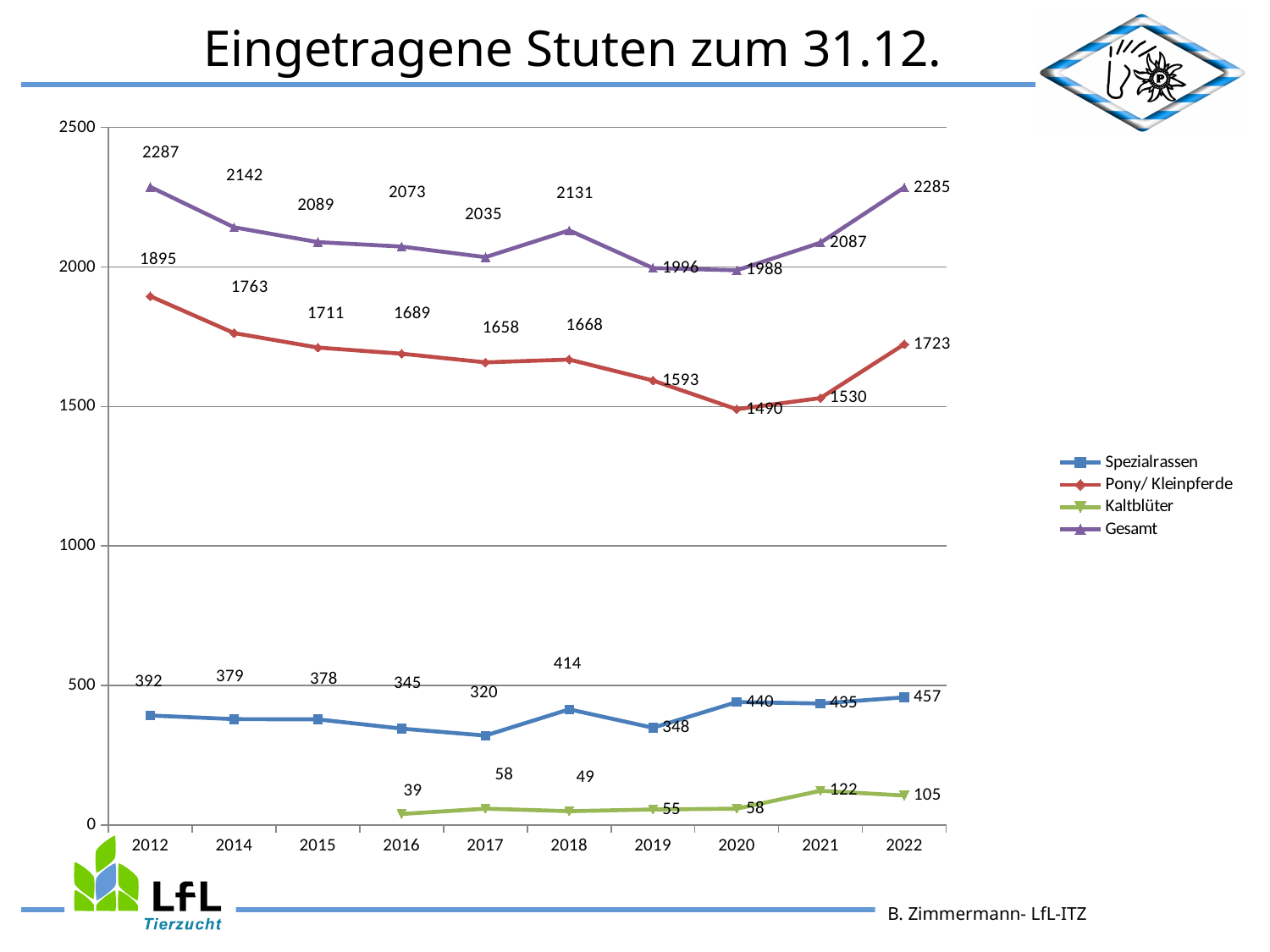
What is the value of the Gesamt series in 2012? 2287 What kind of chart is shown on the slide? line chart Does the Pony/ Kleinpferde series rise or fall from 2012 to 2020? fall What is the difference between the Gesamt value in 2012 and the Gesamt value in 2022? 2 Which year has the larger Spezialrassen value, 2018 or 2019? 2018 In which year does the Pony/ Kleinpferde series reach its lowest value? 2020 What is the value of the Kaltblüter series in 2021? 122 In which year does the Spezialrassen series reach its highest value? 2022 How many years are shown on the x axis? 10 Which series is drawn in green in the legend? Kaltblüter What is the value of the Pony/ Kleinpferde series in 2020? 1490 How many series does the legend list? 4